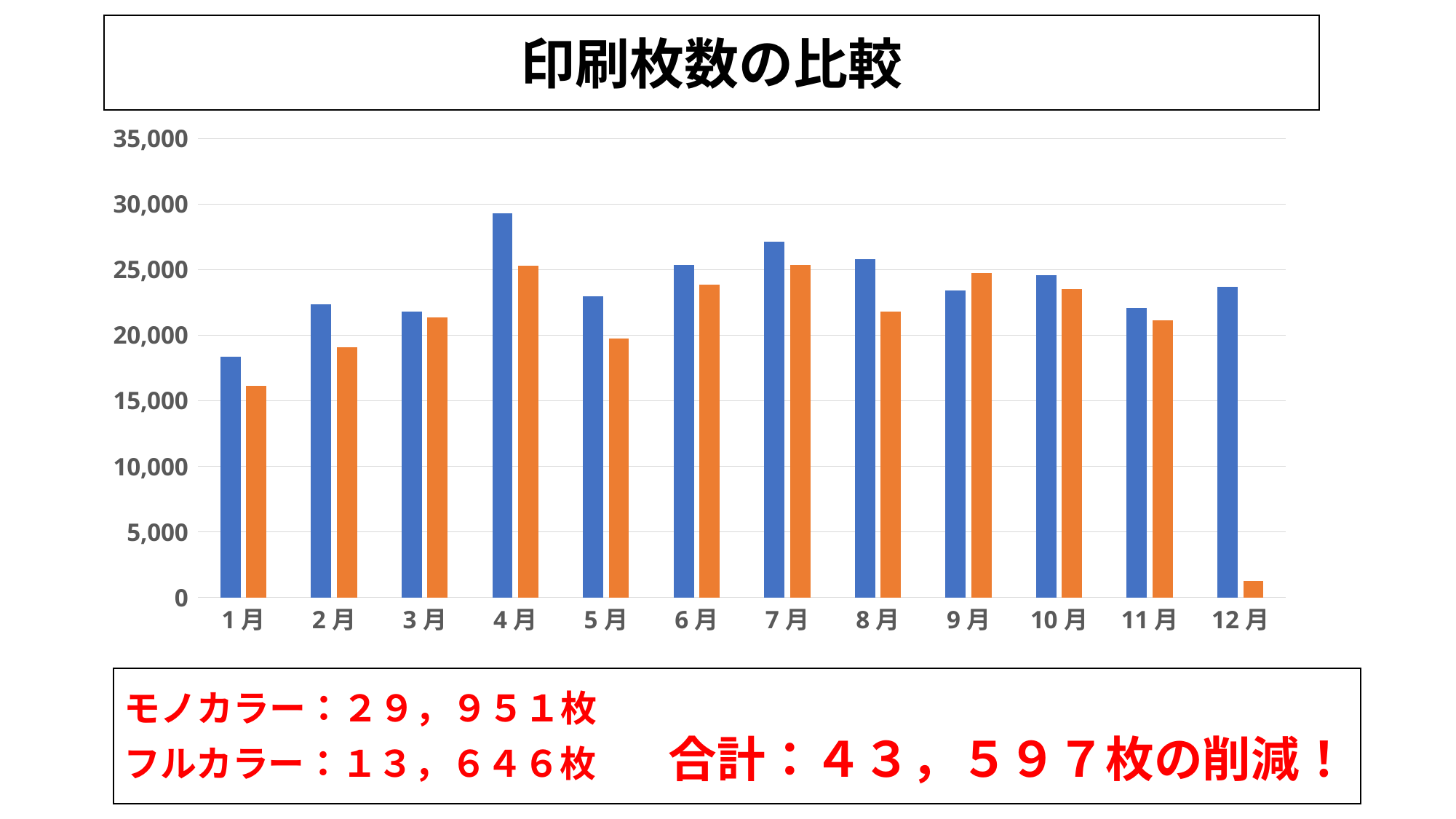
Is the value of the orange bar for 12月 greater or less than 5,000? less In which month is the blue bar the lowest? 1月 What two colours are used for the bars in the chart? blue and orange What is the title of the slide above the chart? 印刷枚数の比較 In 12月, which bar is larger, the blue one or the orange one? blue How many months (categories) are shown on the x axis of the chart? 12 What kind of chart is shown on the slide? bar chart Is the value of the blue bar for 4月 greater or less than 25,000? greater Do the blue bars rise or fall from 1月 to 4月? rise Is the value of the blue bar for 1月 greater or less than 20,000? less In which month is the blue bar the highest? 4月 In which month is the orange bar the lowest? 12月